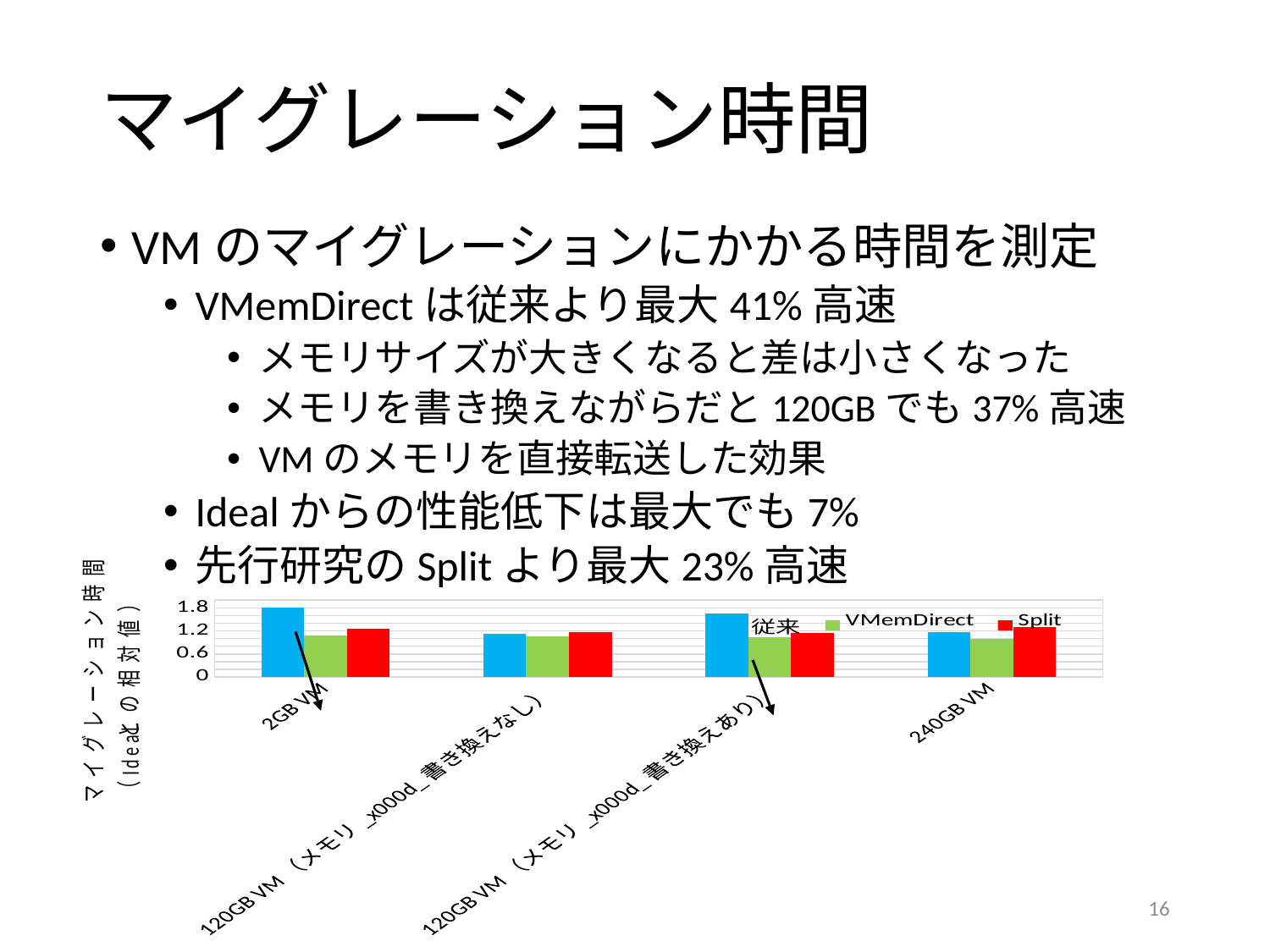
Which series are listed in the chart legend? 従来, VMemDirect, Split For 120GB VM（メモリ書き換えあり）, which is larger: the 従来 value or the Split value? 従来 How many categories are shown on the x axis of the chart? 4 What kind of chart is shown on the slide? bar chart Which category has the highest 従来 value? 2GB VM For 2GB VM, which is larger: the 従来 value or the VMemDirect value? 従来 Is the 従来 value for 2GB VM greater or less than 1.2? greater Is the 従来 value for 120GB VM（メモリ書き換えあり） greater or less than 1.2? greater Is the VMemDirect value for 2GB VM greater or less than 1.2? less What colour are the VMemDirect bars in the chart? green How many series does the chart legend list? 3